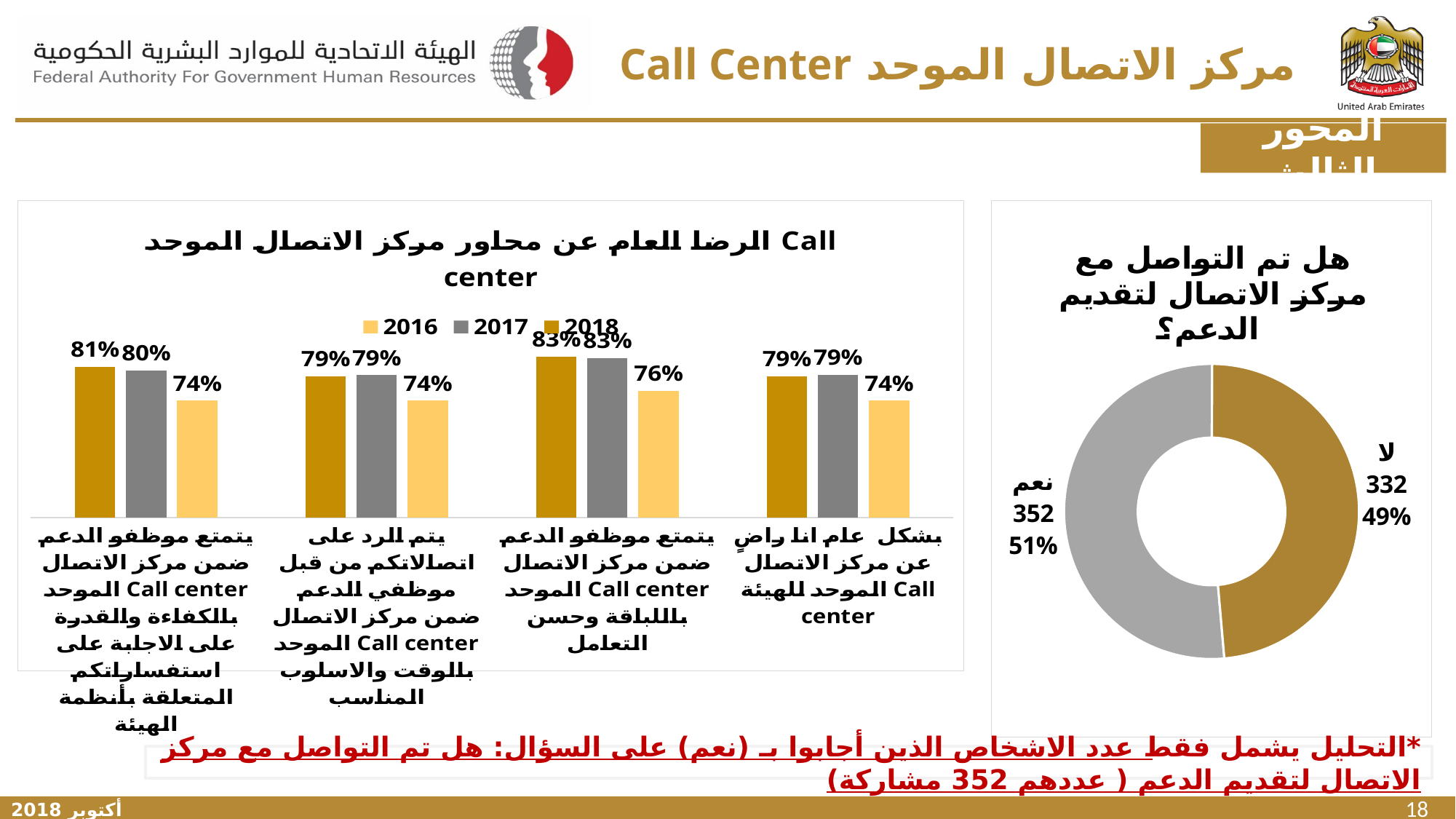
How many series does the legend of the bar chart on the left list? 3 How many categories are shown in the bar chart on the left? 4 In the bar chart on the left, what is the 2016 value for the category 'بشكل عام انا راضٍ عن مركز الاتصال الموحد للهيئة Call center'? 74% In the donut chart on the right, how many respondents answered 'لا'? 332 In the bar chart on the left, what is the 2018 value for the category about support staff being courteous and well-mannered (باللباقة وحسن التعامل)? 83% In the bar chart on the left, which colour represents the 2017 series? Gray In the bar chart on the left, what is the difference between the 2018 and 2016 values for the category about courtesy and good treatment (باللباقة وحسن التعامل)? 7% What kind of chart is the chart on the right titled 'هل تم التواصل مع مركز الاتصال لتقديم الدعم؟'? Donut (pie) chart In the bar chart on the left, which is larger for the competence category (بالكفاءة والقدرة على الاجابة): the 2018 value or the 2016 value? 2018 In the bar chart on the left, what is the 2017 value for the category about support staff being competent and able to answer inquiries (بالكفاءة والقدرة على الاجابة)? 80% In the donut chart on the right, what share of respondents answered 'نعم'? 51% In the bar chart on the left, which category has the highest 2018 value? يتمتع موظفو الدعم ضمن مركز الاتصال الموحد Call center باللباقة وحسن التعامل